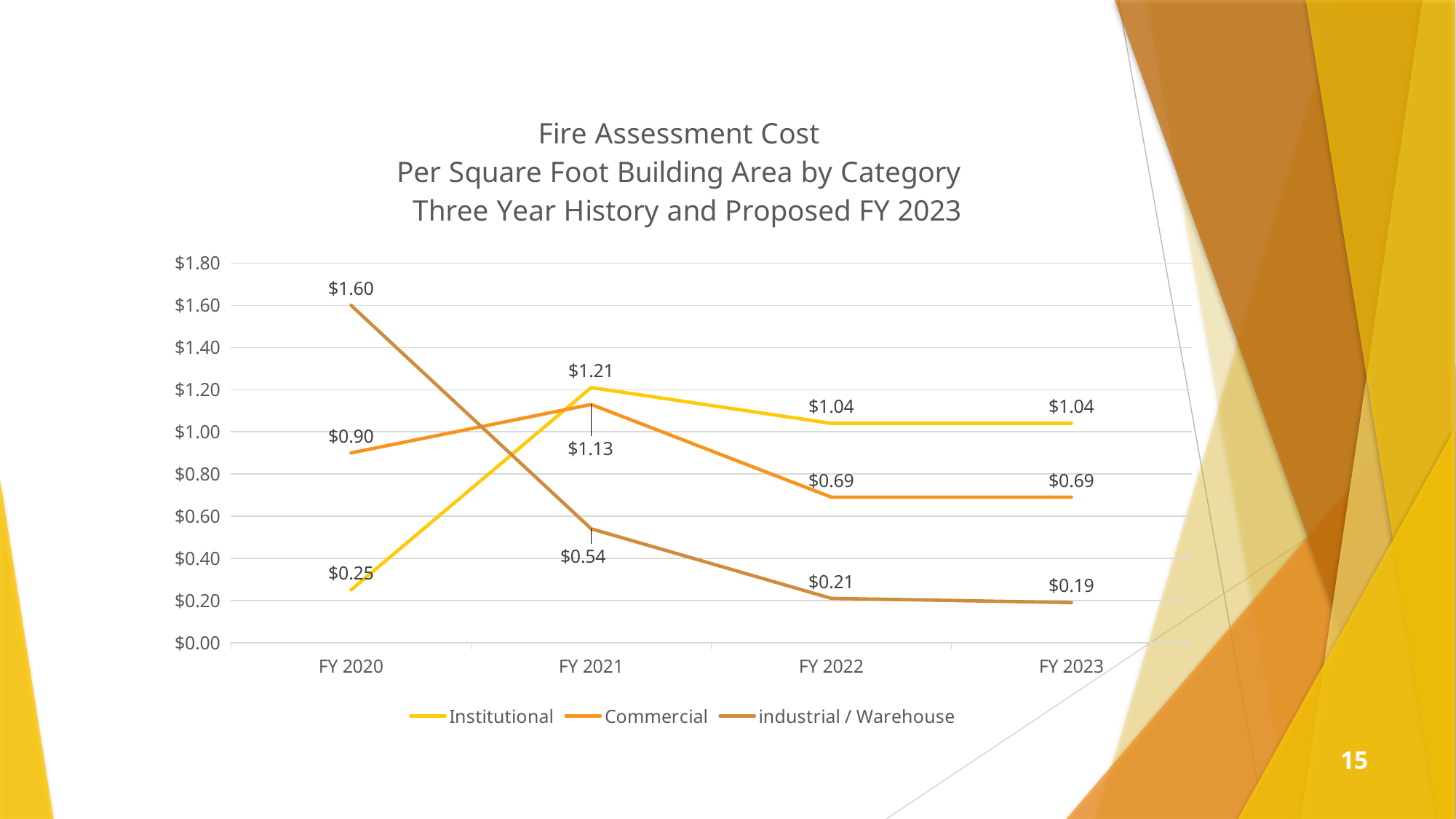
What is the industrial / Warehouse value for FY 2020? $1.60 How many fiscal years are shown on the x axis? 4 How many series does the legend list? 3 What is the industrial / Warehouse value for FY 2023? $0.19 What is the Commercial value for FY 2020? $0.90 What kind of chart is shown? Line chart In which fiscal year is the Institutional value lowest? FY 2020 Which is larger in FY 2022, the Institutional value or the Commercial value? Institutional What is the difference between the industrial / Warehouse values for FY 2020 and FY 2021? $1.06 Does the industrial / Warehouse series rise or fall from FY 2020 to FY 2023? Fall What is the Institutional value for FY 2021? $1.21 In which fiscal year is the Commercial value highest? FY 2021